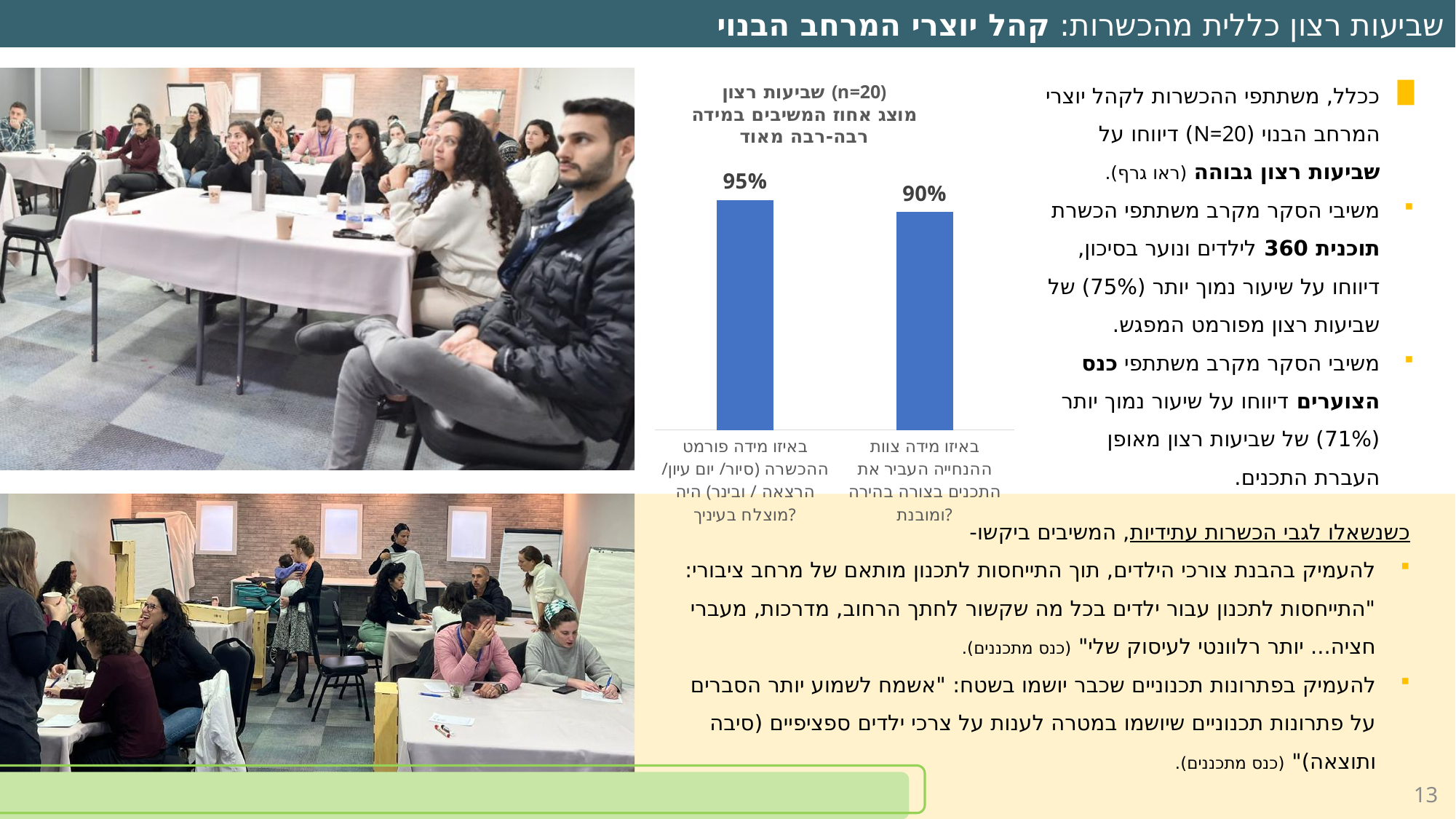
What kind of chart is shown on the slide? Bar chart How many bars does the chart show? 2 What colour are the bars in the chart? Blue Which category has the highest value in the chart? באיזו מידה פורמט ההכשרה (סיור/ יום עיון/ הרצאה / ובינר) היה מוצלח בעיניך? Which is larger: the value for the training format question or the value for the facilitation team question? The training format question (95%) What is the difference between the two bars in the chart? 5% What is the value for the category "באיזו מידה צוות ההנחייה העביר את התכנים בצורה בהירה ומובנת?"? 90% Which category has the lowest value in the chart? באיזו מידה צוות ההנחייה העביר את התכנים בצורה בהירה ומובנת? What is the sample size (n) stated in the chart title? n=20 What is the value for the category "באיזו מידה פורמט ההכשרה (סיור/ יום עיון/ הרצאה / ובינר) היה מוצלח בעיניך?"? 95% Do the values fall or rise from the left bar to the right bar? Fall